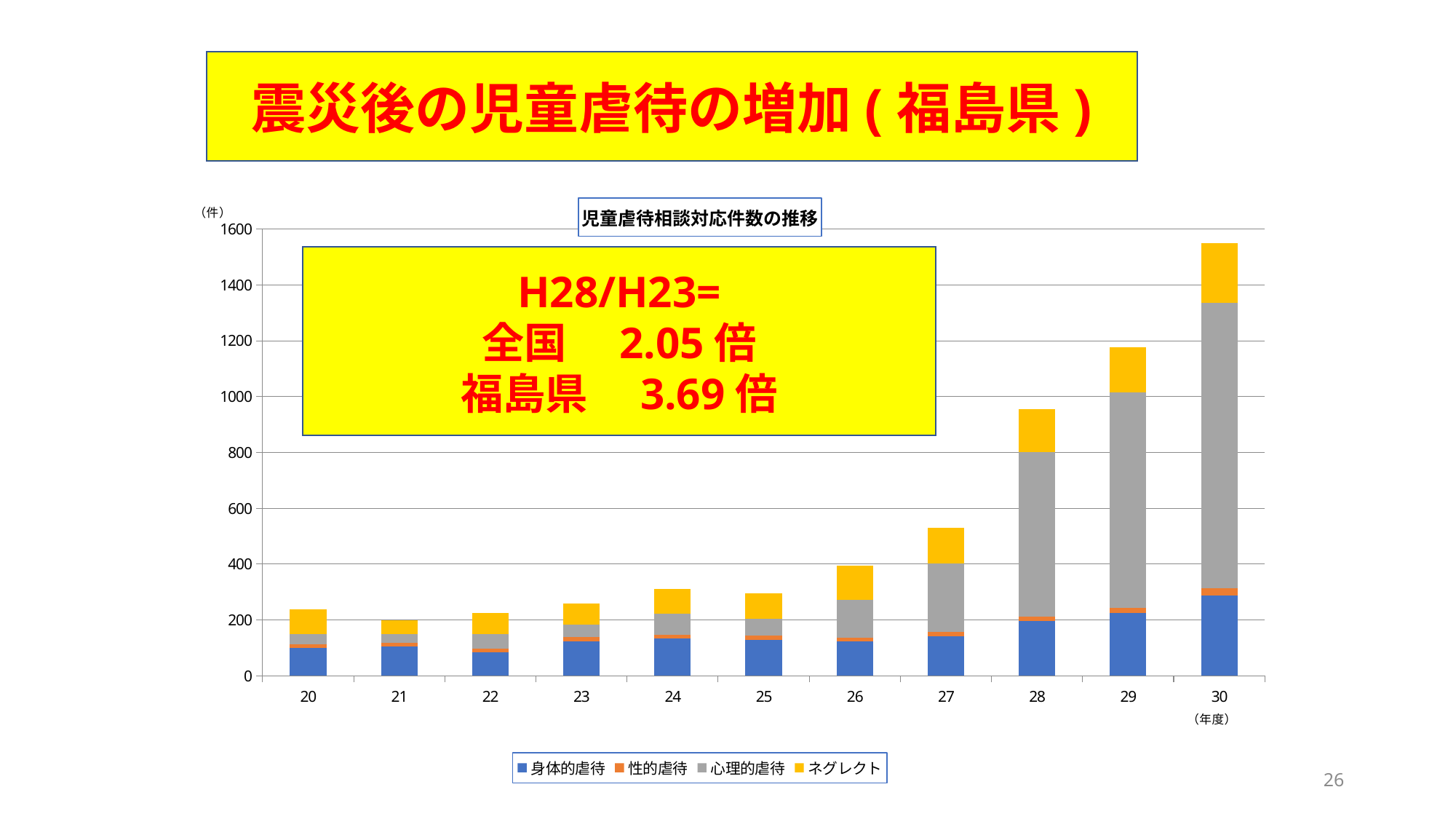
What kind of chart is shown on the slide? stacked bar chart Is the total value for year 27 greater or less than 600? less Is the total value for year 29 greater or less than 1000? greater Which year has the highest total number of cases in the chart? 30 How many series does the chart's legend list? 4 What is the title of the chart? 児童虐待相談対応件数の推移 Is the total value for year 30 greater or less than 1400? greater How many years (categories) are shown on the x axis of the chart? 11 Do the total values generally rise or fall from year 20 to year 30? rise Which year has the larger total, 28 or 29? 29 Which series is shown in yellow in the chart's legend? ネグレクト